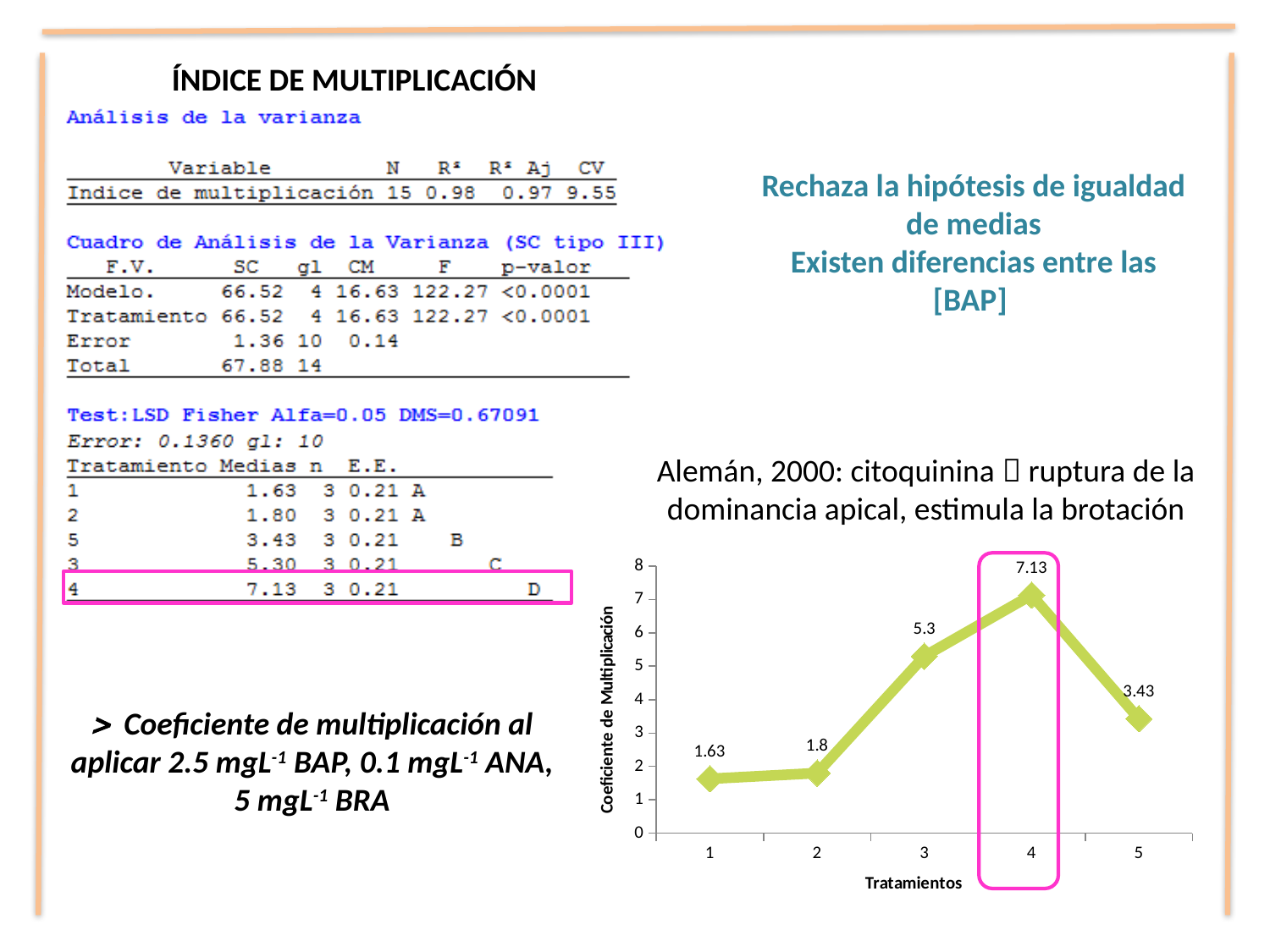
How many Tratamientos are plotted on the chart? 5 Does the Coeficiente de Multiplicación rise or fall from Tratamiento 1 to Tratamiento 4? rise What is the Coeficiente de Multiplicación for Tratamiento 5? 3.43 What is the Coeficiente de Multiplicación for Tratamiento 1? 1.63 What kind of chart is shown on the slide? line chart Is the value for Tratamiento 2 greater or less than 3? less Which Tratamiento has the highest Coeficiente de Multiplicación? 4 What is the Coeficiente de Multiplicación for Tratamiento 4? 7.13 Which has a larger Coeficiente de Multiplicación, Tratamiento 3 or Tratamiento 5? Tratamiento 3 What is the difference between the Coeficiente de Multiplicación for Tratamiento 4 and Tratamiento 3? 1.83 What is the label of the x axis of the chart? Tratamientos Which Tratamiento has the lowest Coeficiente de Multiplicación? 1